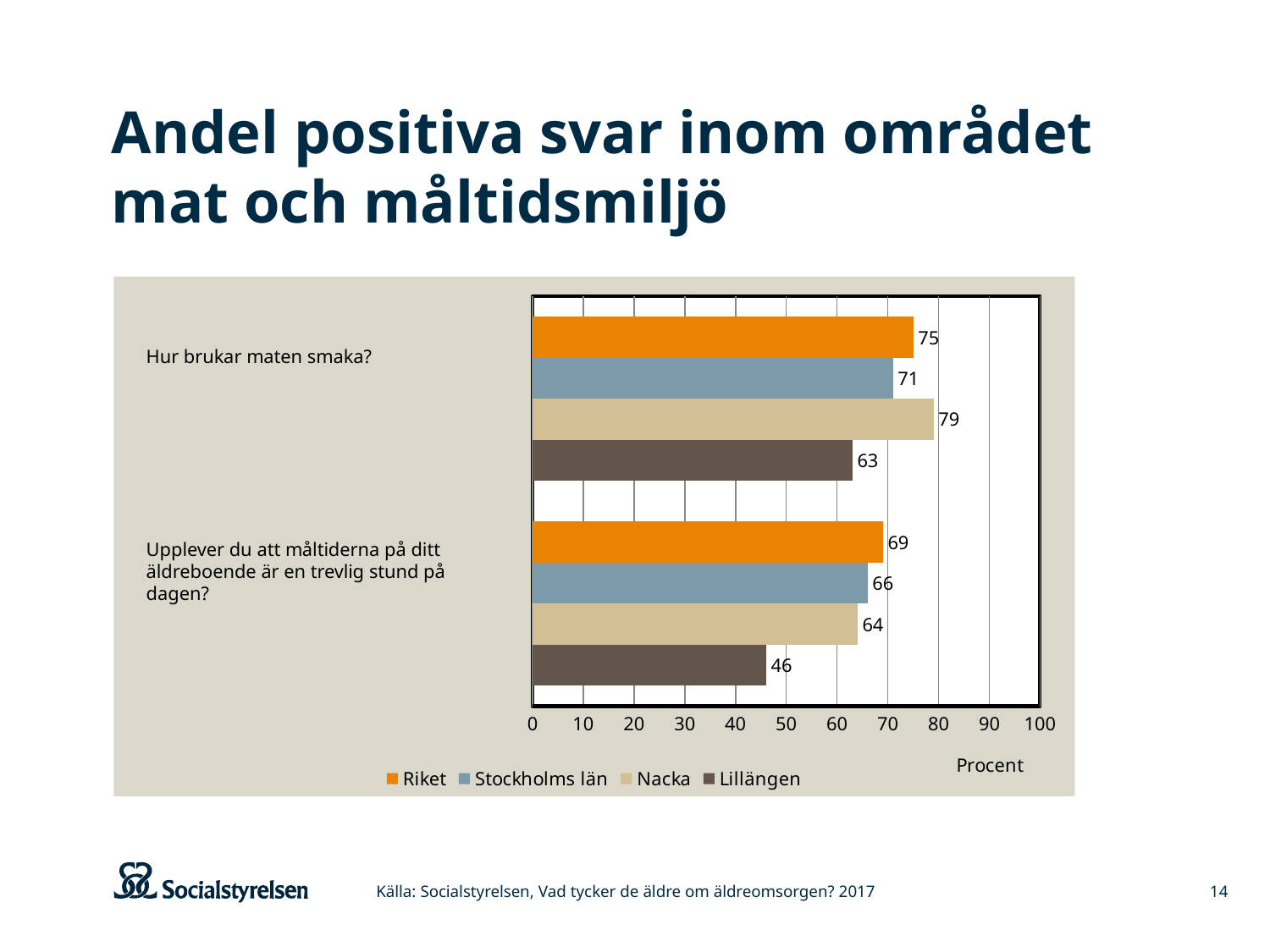
What is the value for Stockholms län for the question "Upplever du att måltiderna på ditt äldreboende är en trevlig stund på dagen?"? 66 Which is larger for "Upplever du att måltiderna på ditt äldreboende är en trevlig stund på dagen?": Riket or Nacka? Riket What unit is shown on the x axis of the chart? Procent How many questions (categories) are shown on the chart? 2 Which series has the highest value for "Hur brukar maten smaka?"? Nacka Which series has the lowest value for "Upplever du att måltiderna på ditt äldreboende är en trevlig stund på dagen?"? Lillängen What is the value for Riket for the question "Hur brukar maten smaka?"? 75 How many series does the legend list? 4 What is the value for Lillängen for the question "Upplever du att måltiderna på ditt äldreboende är en trevlig stund på dagen?"? 46 What is the difference between the Nacka and Lillängen values for "Hur brukar maten smaka?"? 16 What kind of chart is shown on the slide? Bar chart What is the value for Nacka for the question "Hur brukar maten smaka?"? 79